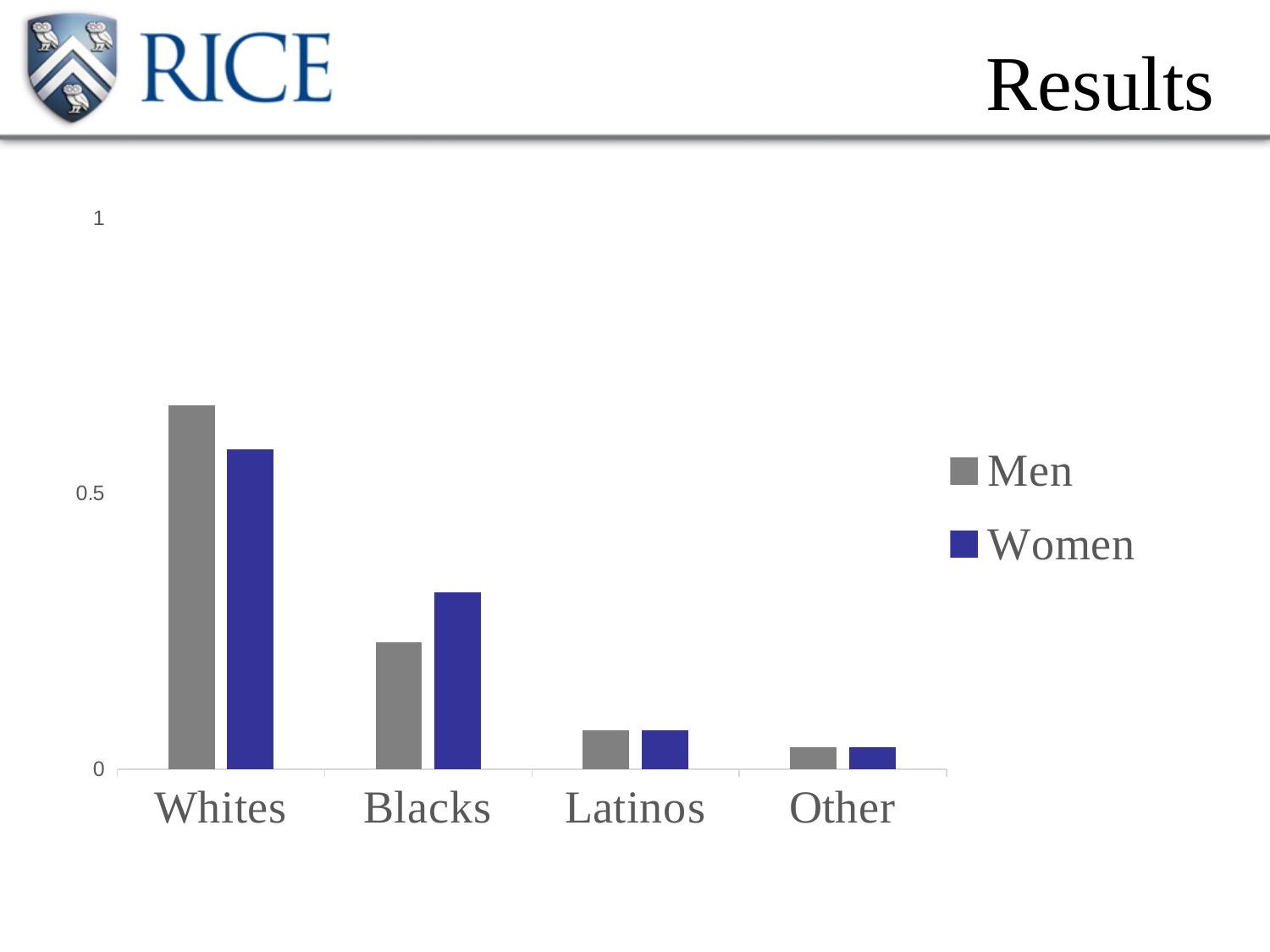
What is the title of the slide containing the chart? Results Is the value for Women among Blacks greater or less than 0.5? less Which category has the lowest value for Women? Other How many categories are shown on the x axis of the chart? 4 How many series does the chart's legend list? 2 Which category has the highest value for Men? Whites For Blacks, which is larger, the value for Men or the value for Women? Women Which colour represents the Women series in the chart? blue Do the values for Men rise or fall moving from Whites to Other along the x axis? fall For Whites, which is larger, the value for Men or the value for Women? Men Is the value for Men among Whites greater or less than 0.5? greater What kind of chart is shown on the slide? bar chart